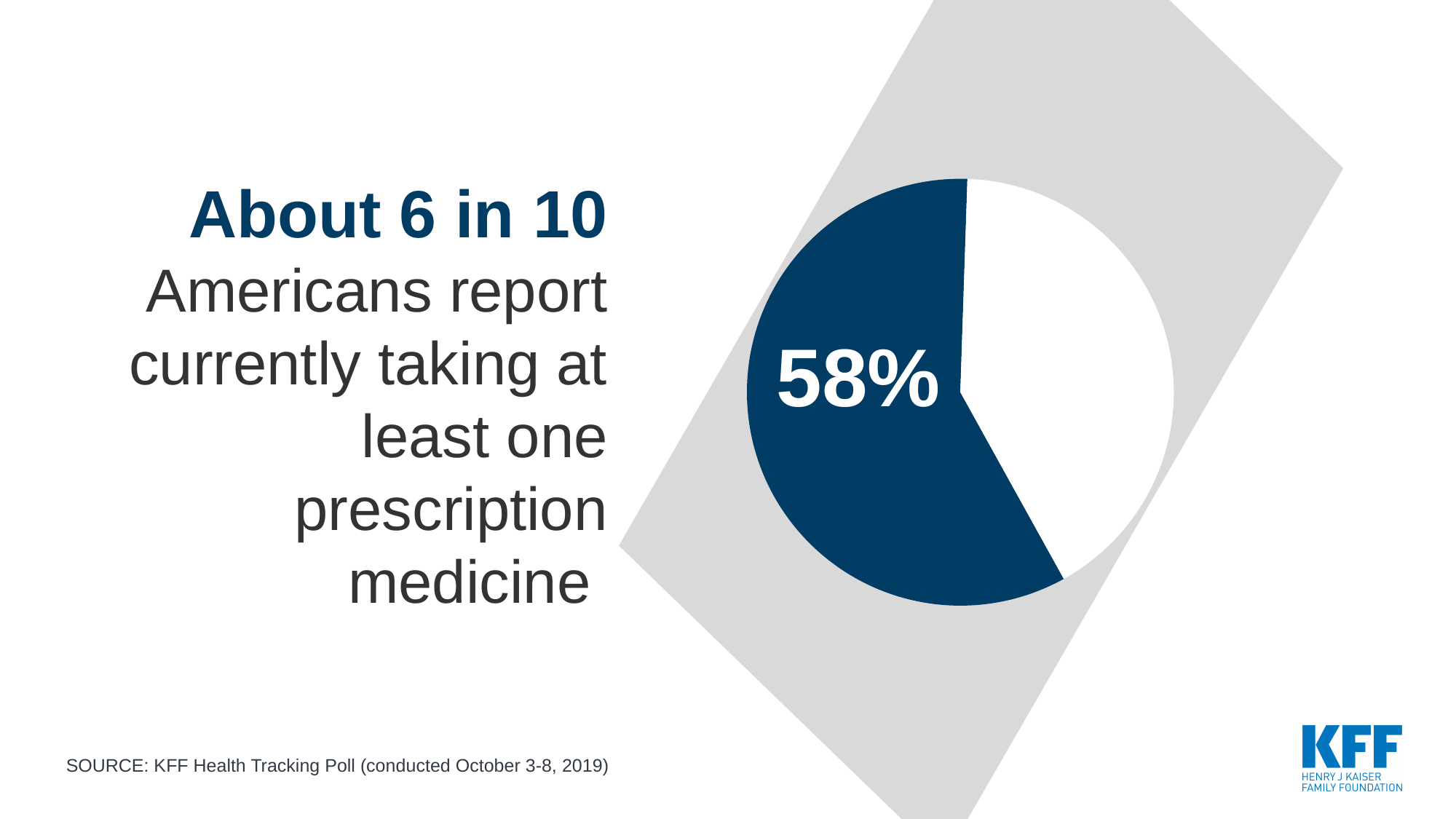
What share of the pie does the dark blue slice represent? 58% What percentage is printed on the dark blue slice of the pie chart? 58% What colour is the slice labelled 58%? dark blue Is the value shown on the dark blue slice greater or less than 50%? greater How many slices does the pie chart have? 2 What kind of chart is shown on the slide? pie chart Is the value shown on the dark blue slice greater or less than 60%? less According to the slide text, about how many in 10 Americans report currently taking at least one prescription medicine? About 6 in 10 Which slice of the pie chart is larger, the dark blue slice or the white slice? the dark blue slice